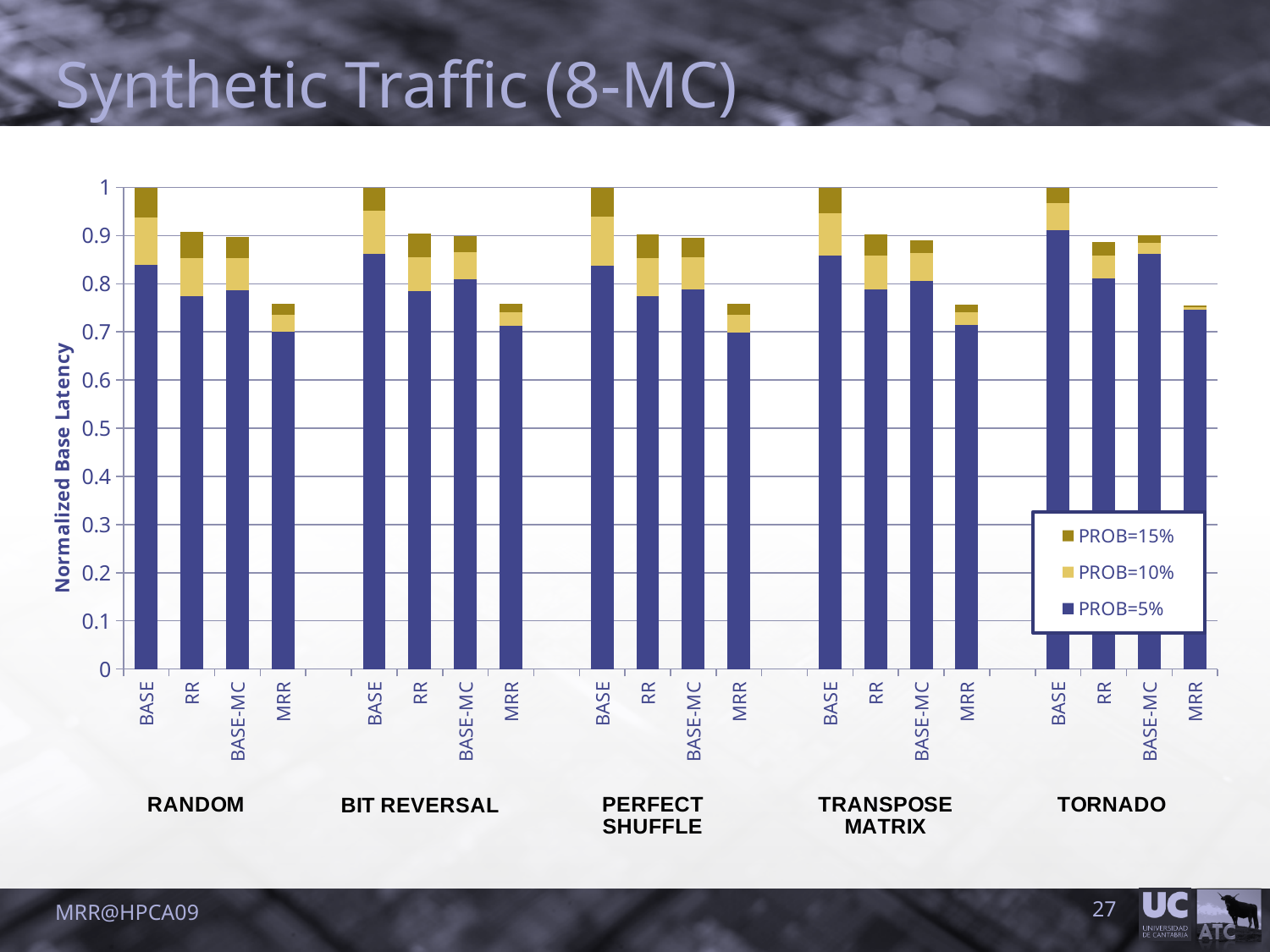
Is the total value for MRR in the RANDOM group greater or less than 0.7? greater In the TORNADO group, which has the larger total bar, BASE-MC or MRR? BASE-MC How many series does the legend list? 3 Which configuration has the highest total bar in the PERFECT SHUFFLE group? BASE What kind of chart is shown on the slide? stacked bar chart What is the label of the y axis? Normalized Base Latency What are the three legend entries? PROB=15%, PROB=10%, PROB=5% Is the total value for MRR in the TRANSPOSE MATRIX group greater or less than 0.8? less How many traffic patterns are shown along the x axis? 5 What is the total stacked height of the BASE bar in the RANDOM group? 1 Which configuration has the lowest total bar in the BIT REVERSAL group? MRR How many bars are plotted for the TORNADO traffic pattern? 4